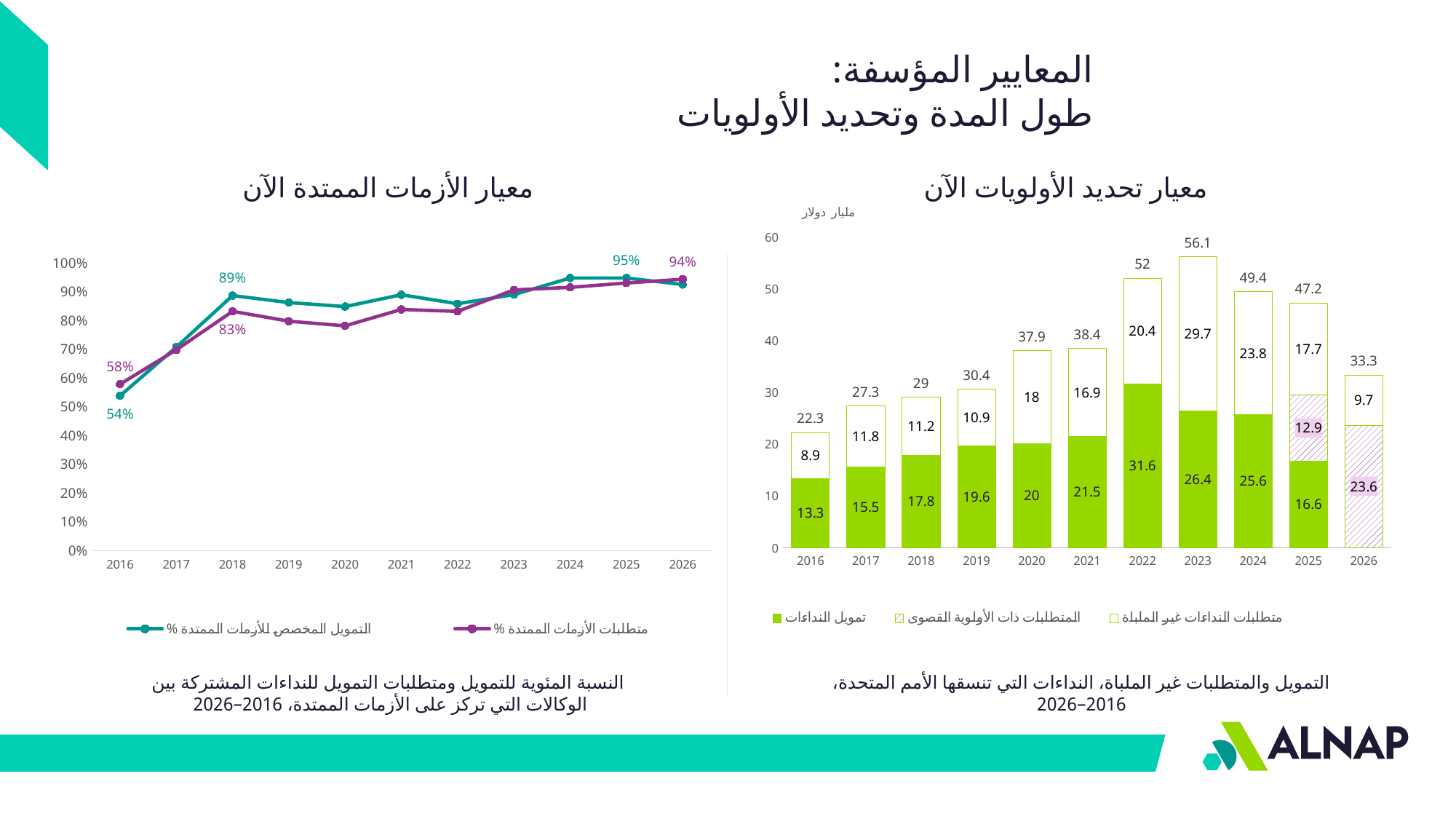
In the chart titled "معيار تحديد الأولويات الآن" (right), what is the value of the green "تمويل النداءات" segment for 2022? 31.6 In the chart titled "معيار الأزمات الممتدة الآن" (left), what is the value of the "التمويل المخصص للأزمات الممتدة %" series in 2016? 54% In the chart titled "معيار تحديد الأولويات الآن" (right), what is the value of the hatched "المتطلبات ذات الأولوية القصوى" segment for 2025? 12.9 In the chart titled "معيار الأزمات الممتدة الآن" (left), what is the value of the "متطلبات الأزمات الممتدة %" series in 2018? 83% What kind of chart is the one titled "معيار الأزمات الممتدة الآن" (left)? Line chart In the chart titled "معيار تحديد الأولويات الآن" (right), what is the difference between the total bar for 2022 and the total bar for 2021? 13.6 In the chart titled "معيار تحديد الأولويات الآن" (right), what is the value of the white "متطلبات النداءات غير الملباة" segment for 2020? 18 In the chart titled "معيار تحديد الأولويات الآن" (right), what is the total value of the stacked bar for 2023? 56.1 In the chart titled "معيار تحديد الأولويات الآن" (right), which year has the lowest total bar? 2016 In the chart titled "معيار تحديد الأولويات الآن" (right), how many series does the legend list? 3 In the chart titled "معيار تحديد الأولويات الآن" (right), which year has the highest total bar? 2023 In the chart titled "معيار الأزمات الممتدة الآن" (left), is the value of the "التمويل المخصص للأزمات الممتدة %" series in 2020 greater or less than 80%? greater